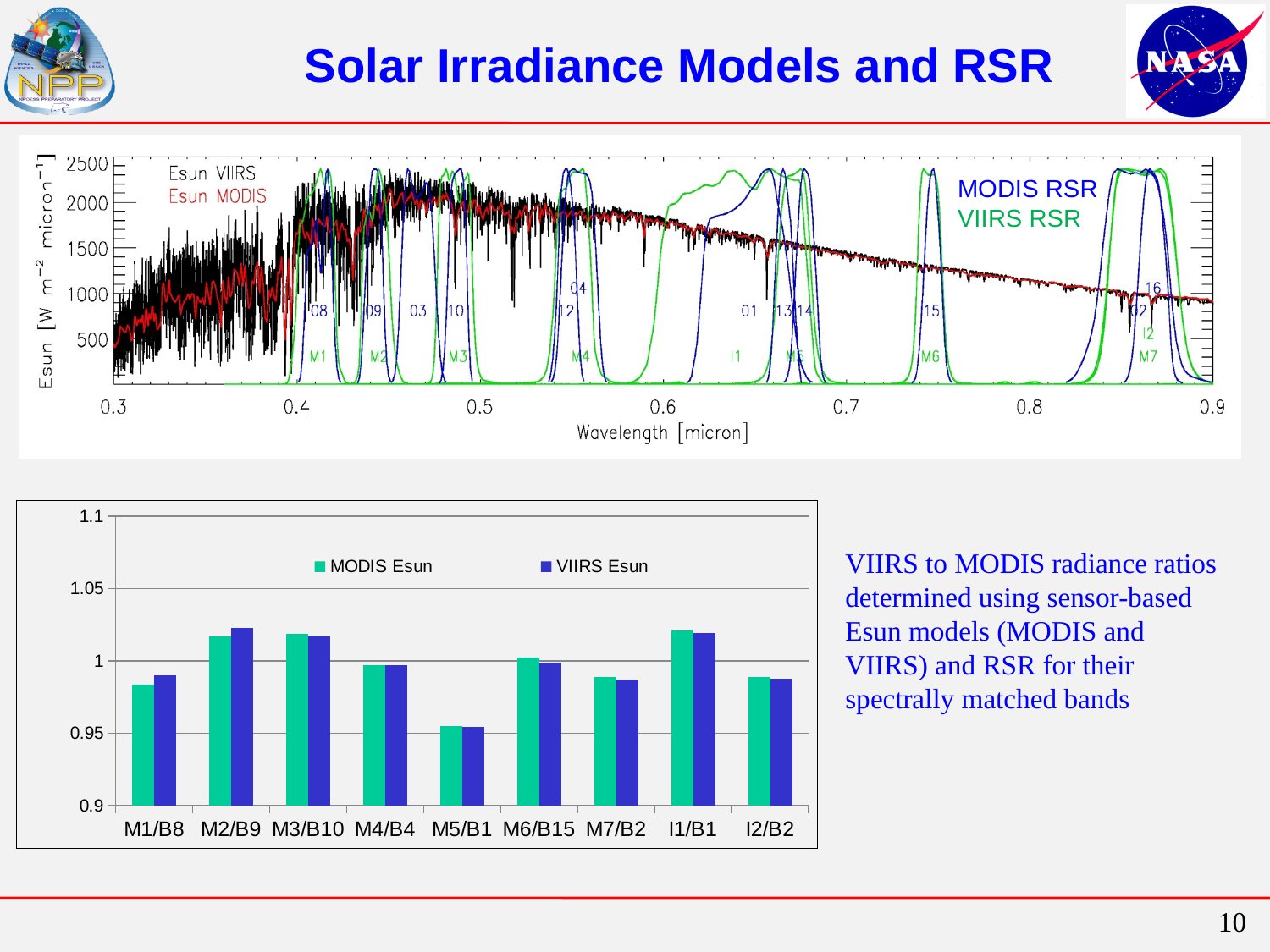
In the top chart, what is the label of the x axis? Wavelength [micron] In the bottom chart, is the MODIS Esun value for M5/B1 greater or less than 1? less In the bottom chart, how many band-pair categories are shown on the x axis? 9 In the bottom chart, is the MODIS Esun value for M1/B8 greater or less than 1? less In the bottom chart, how many series does the legend list? 2 In the bottom chart, is the VIIRS Esun value for M2/B9 greater or less than 1? greater In the bottom chart, what kind of chart is used to show the MODIS Esun and VIIRS Esun values? bar chart In the bottom chart, which band pair has the lowest values for both series? M5/B1 In the bottom chart, for M1/B8, which series has the larger value, MODIS Esun or VIIRS Esun? VIIRS Esun In the bottom chart, which is larger, the MODIS Esun value for M2/B9 or the MODIS Esun value for M5/B1? M2/B9 In the top chart, which two Esun models are listed in the legend? Esun VIIRS and Esun MODIS